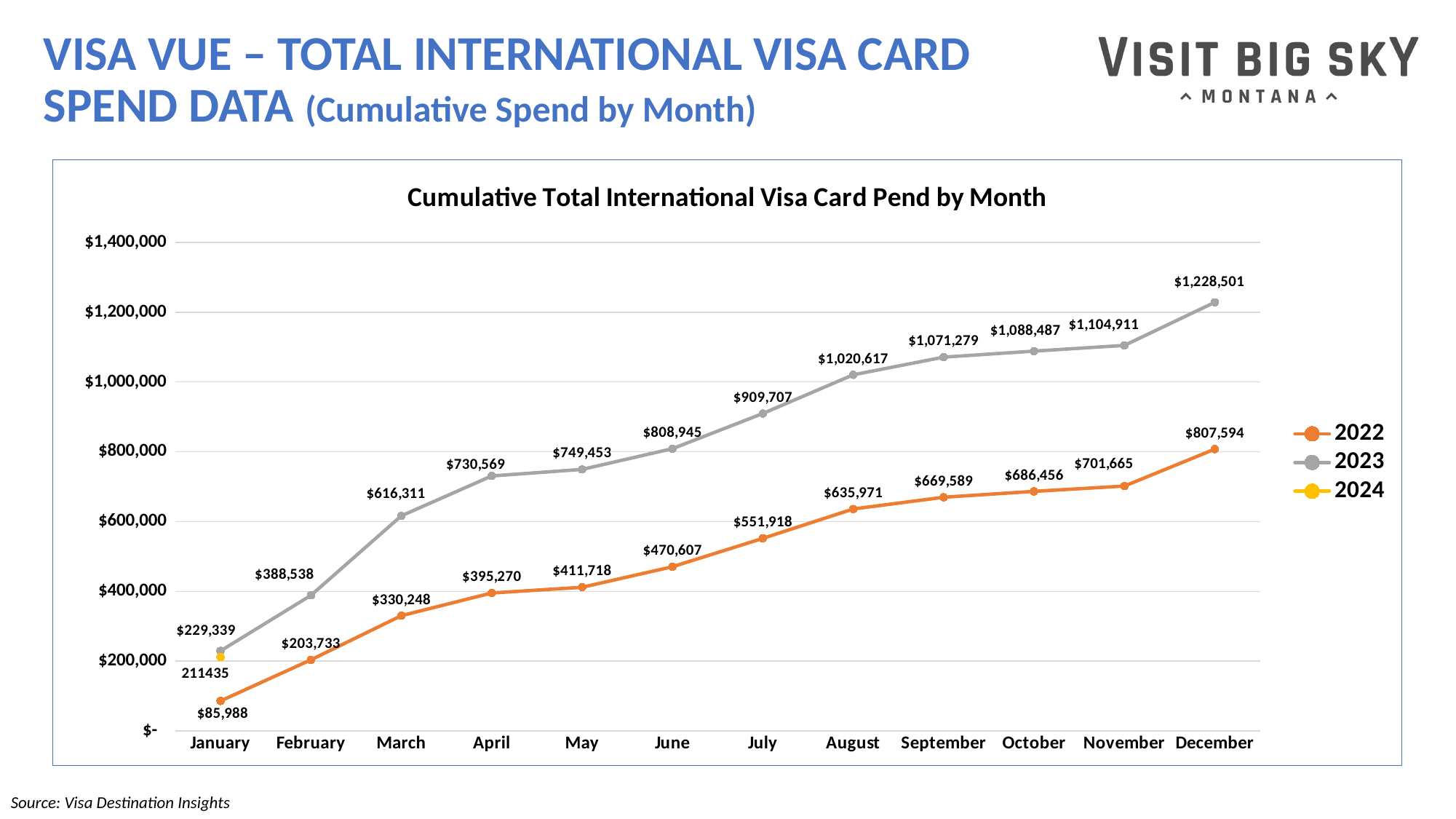
How many months are shown on the x axis? 12 Do the 2023 values rise or fall from January to December? Rise What value is shown for the 2024 series in January? 211435 What is the difference between the December values for 2023 and 2022? $420,907 In which month is the 2023 series at its highest? December In which month is the 2022 series at its lowest? January What kind of chart is shown on the slide? Line chart What is the cumulative spend for 2022 in July? $551,918 Which is larger in January: the 2023 value or the 2024 value? 2023 How many series does the legend list? 3 What is the cumulative spend for 2023 in December? $1,228,501 What is the cumulative spend for 2023 in March? $616,311